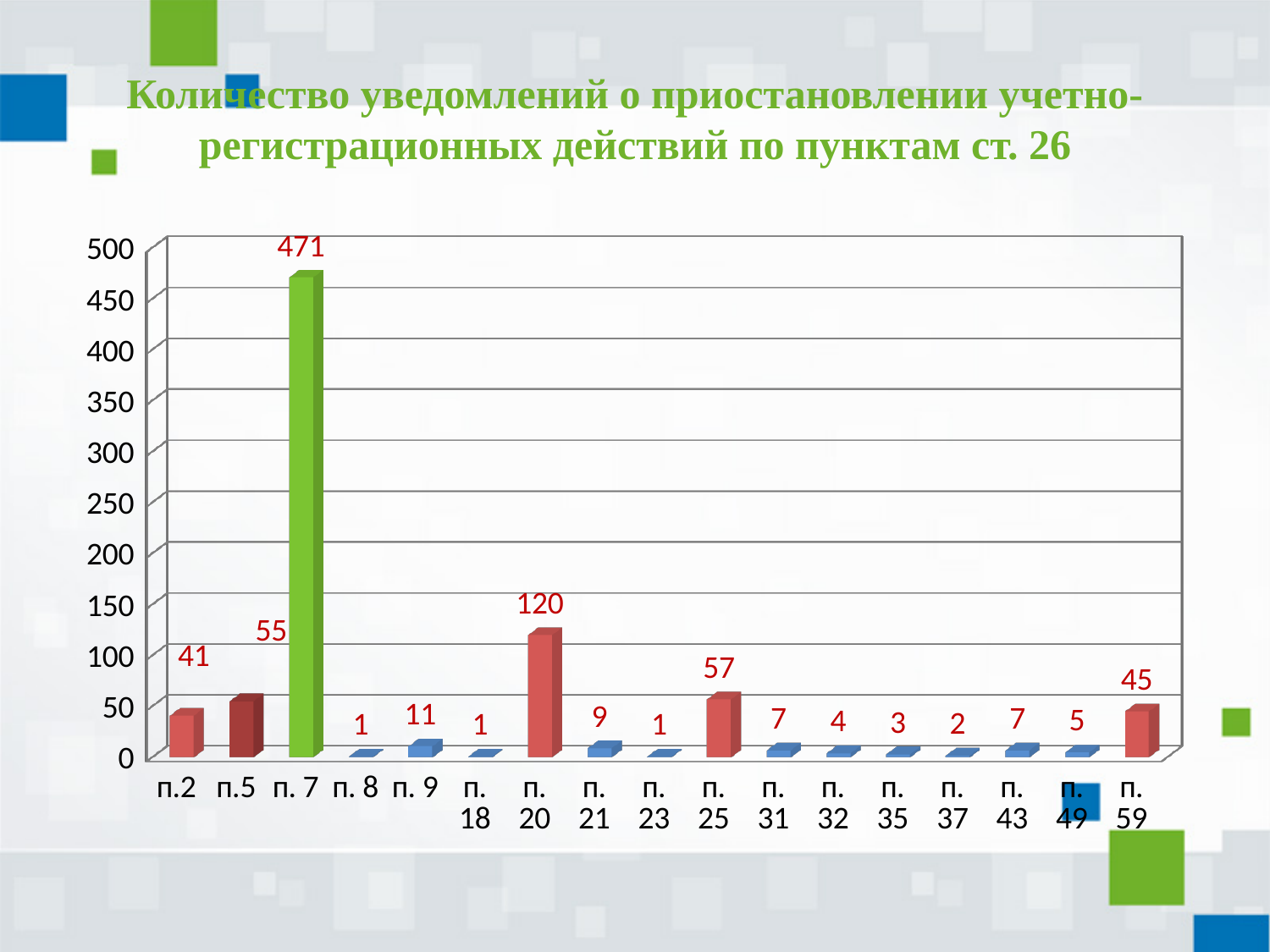
Is the value for п. 20 greater or less than 100? greater What kind of chart is shown on the slide? bar chart Which category has the highest value? п. 7 What is the value for п. 20? 120 What colour is the bar for п. 7? green How many categories are shown on the x axis? 17 What is the difference between the values for п. 7 and п. 20? 351 Which is larger, the value for п. 25 or the value for п. 59? п. 25 What is the value for п. 59? 45 What is the difference between the values for п.5 and п.2? 14 What is the value for п. 25? 57 What is the value for п. 7? 471